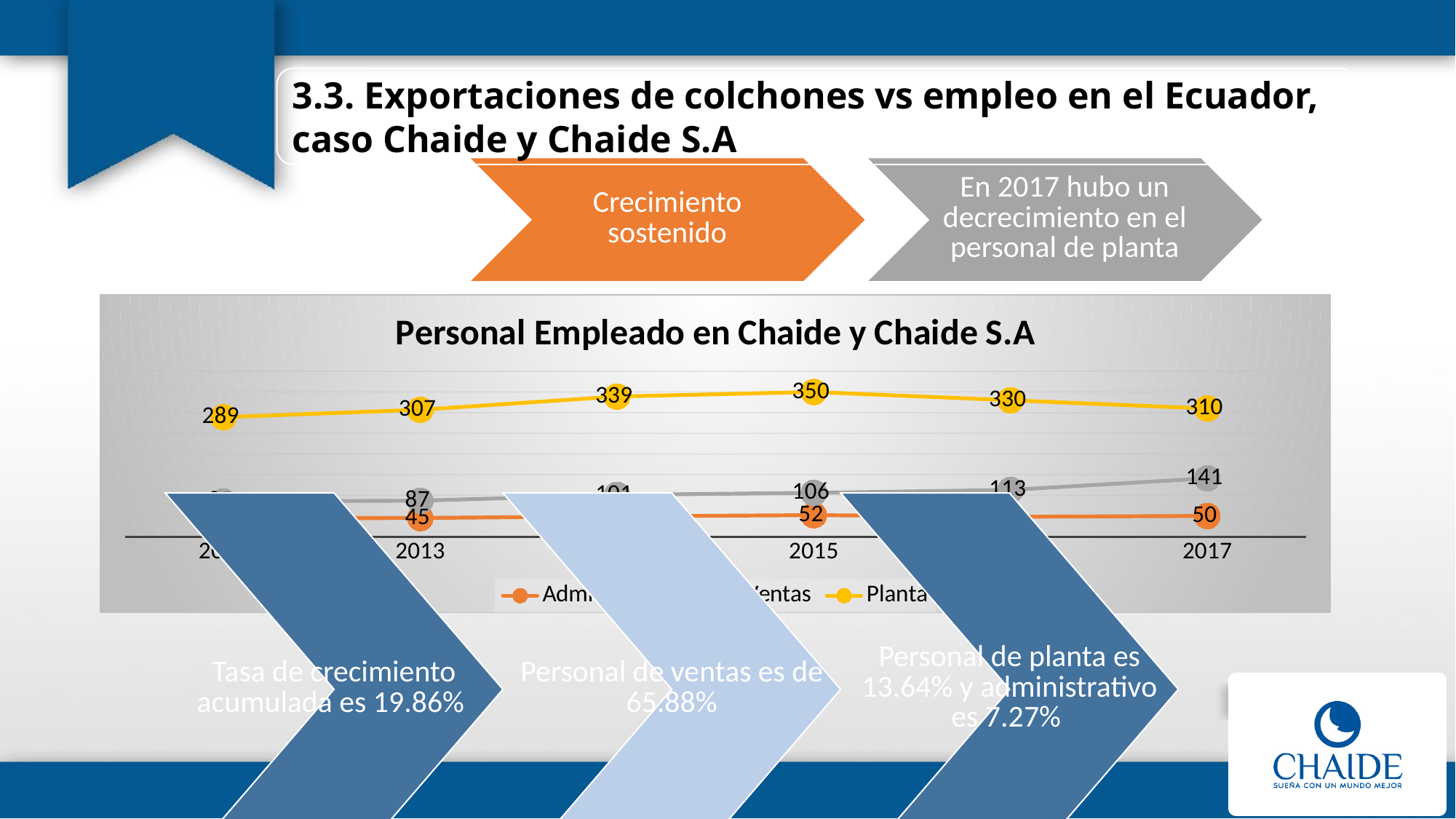
In the chart 'Personal Empleado en Chaide y Chaide S.A', in which year does the Planta line reach its highest value? 2015 In the chart 'Personal Empleado en Chaide y Chaide S.A', does the Ventas line rise or fall from 2013 to 2017? Rises In the chart 'Personal Empleado en Chaide y Chaide S.A', what is the Ventas value for 2013? 87 In the chart 'Personal Empleado en Chaide y Chaide S.A', what is the difference between the Planta values for 2015 and 2017? 40 In the chart 'Personal Empleado en Chaide y Chaide S.A', what is the Planta value for 2015? 350 What kind of chart is 'Personal Empleado en Chaide y Chaide S.A'? Line chart How many series does the legend of 'Personal Empleado en Chaide y Chaide S.A' list? 3 In the chart 'Personal Empleado en Chaide y Chaide S.A', what is the Planta value for 2017? 310 In the chart 'Personal Empleado en Chaide y Chaide S.A', what is the Planta value for 2013? 307 In the chart 'Personal Empleado en Chaide y Chaide S.A', what is the Ventas value for 2017? 141 In the chart 'Personal Empleado en Chaide y Chaide S.A', what is the Admin value for 2017? 50 In the chart 'Personal Empleado en Chaide y Chaide S.A', which is larger in 2017, Ventas or Admin? Ventas